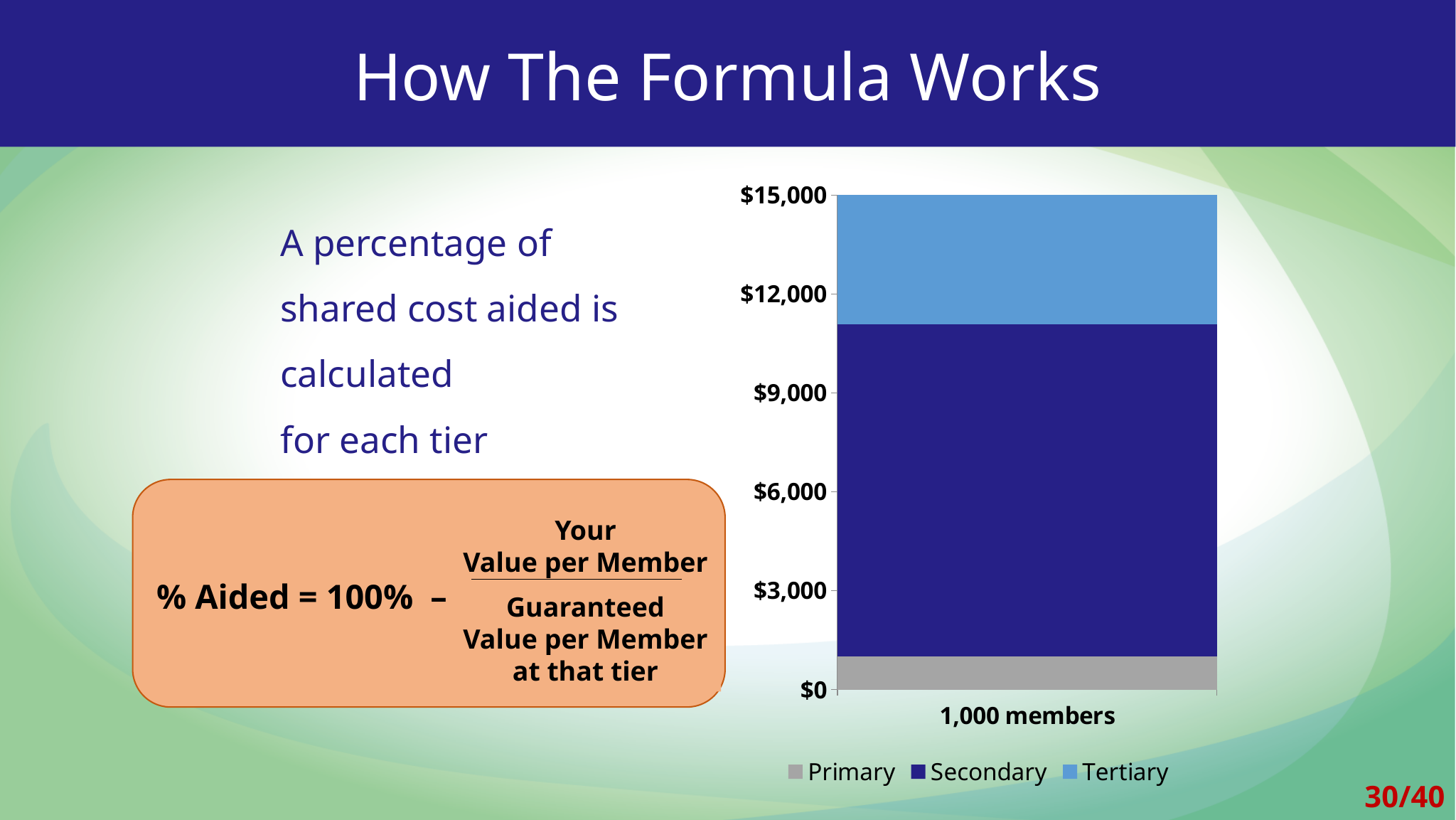
Which series are listed in the chart legend? Primary, Secondary, Tertiary What kind of chart is shown on the slide? Stacked bar chart What is the total height of the stacked bar for 1,000 members? $15,000 What is the label of the single category on the x axis? 1,000 members How many series does the chart legend list? 3 Is the value of the Primary segment greater or less than $3,000? less Which series makes up the smallest portion of the stacked bar? Primary Is the value of the Tertiary segment greater or less than $6,000? less Which is larger, the Secondary segment or the Tertiary segment of the bar? Secondary How many categories are shown on the x axis of the chart? 1 Which series makes up the largest portion of the stacked bar? Secondary Is the value of the Secondary segment greater or less than $9,000? greater